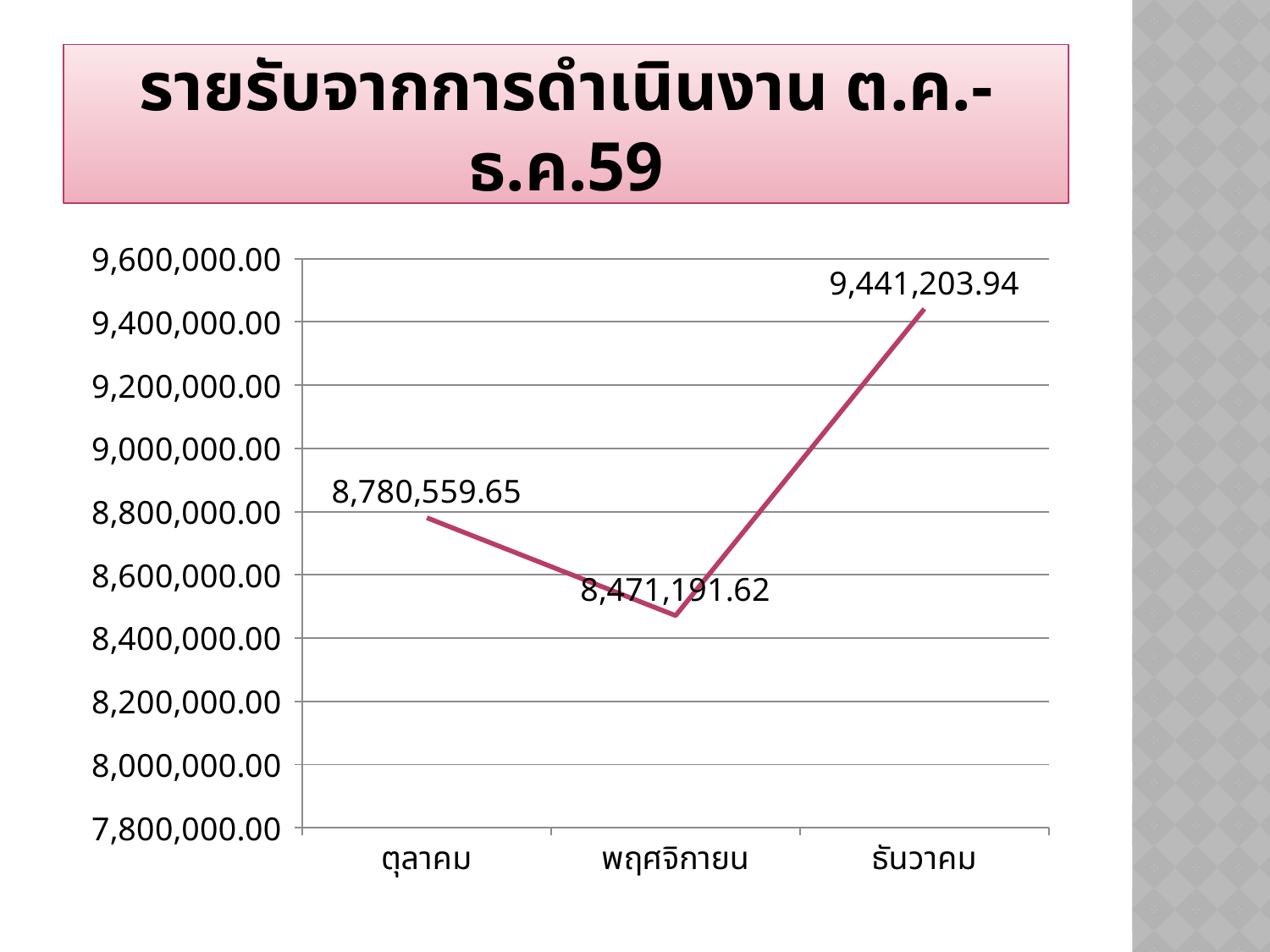
Which month has the highest value? ธันวาคม What is the value for ธันวาคม? 9,441,203.94 What is the title of the chart? รายรับจากการดำเนินงาน ต.ค.-ธ.ค.59 What is the difference between the values for ธันวาคม and ตุลาคม? 660,644.29 What is the value for พฤศจิกายน? 8,471,191.62 Which is larger, the value for ตุลาคม or the value for พฤศจิกายน? ตุลาคม Is the value for พฤศจิกายน greater or less than 8,600,000.00? less How many months are plotted on the chart? 3 What kind of chart is shown on the slide? line chart What is the difference between the values for ตุลาคม and พฤศจิกายน? 309,368.03 Which month has the lowest value? พฤศจิกายน What is the value for ตุลาคม? 8,780,559.65